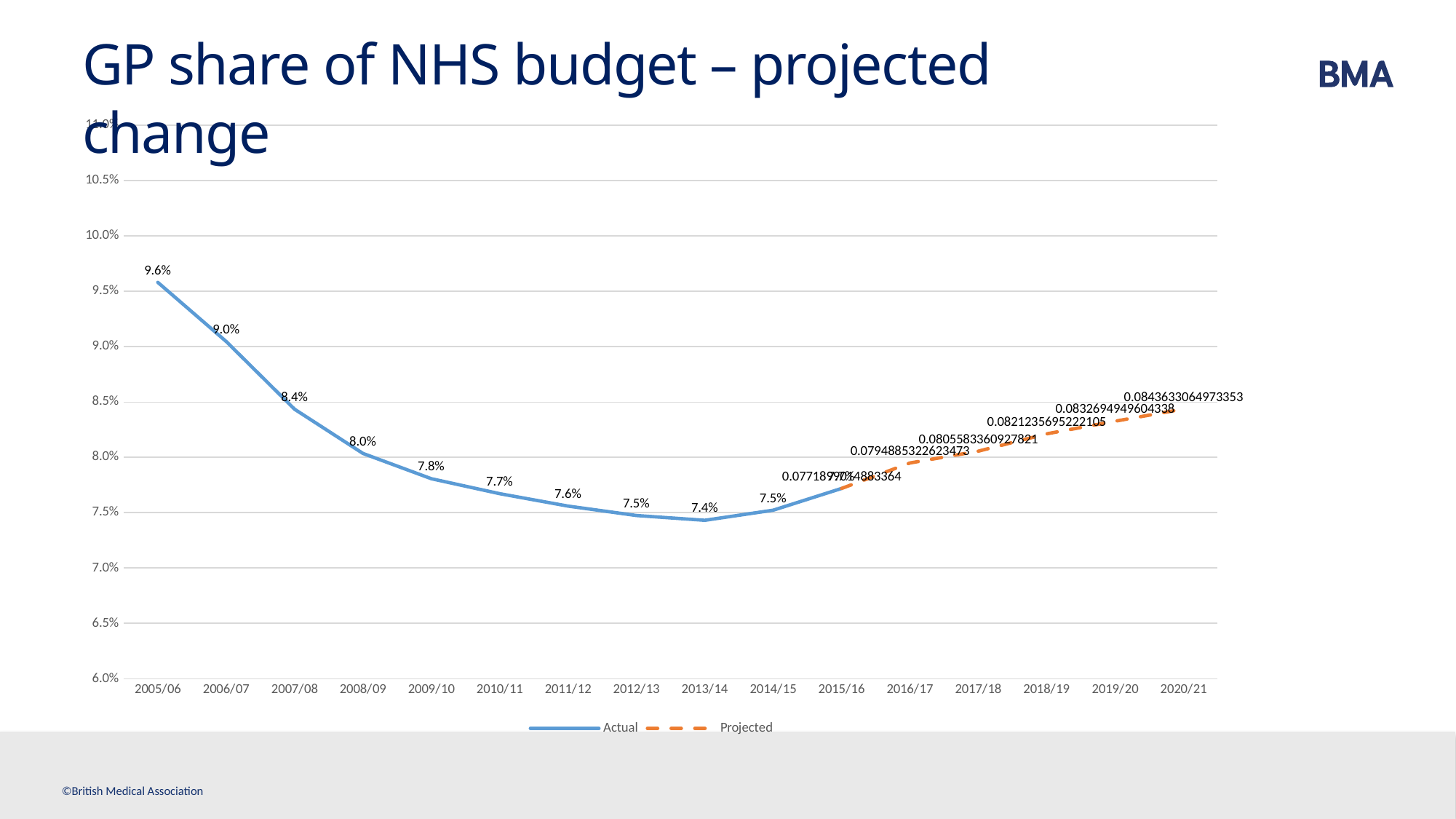
What is the data label shown for the projected value in 2020/21? 0.0843633064973353 What is the GP share of NHS budget for 2013/14? 7.4% How many series does the legend list? 2 In which year is the Actual GP share of NHS budget lowest? 2013/14 What is the GP share of NHS budget for 2005/06? 9.6% Which year has the larger GP share: 2007/08 or 2009/10? 2007/08 Does the Actual GP share rise or fall from 2005/06 to 2013/14? fall Is the projected value for 2018/19 greater or less than 8.0%? greater In which year is the Actual GP share of NHS budget highest? 2005/06 What is the difference between the GP share in 2005/06 and in 2013/14? 2.2 percentage points What kind of chart is shown on the slide? line chart How many years are shown on the x axis? 16